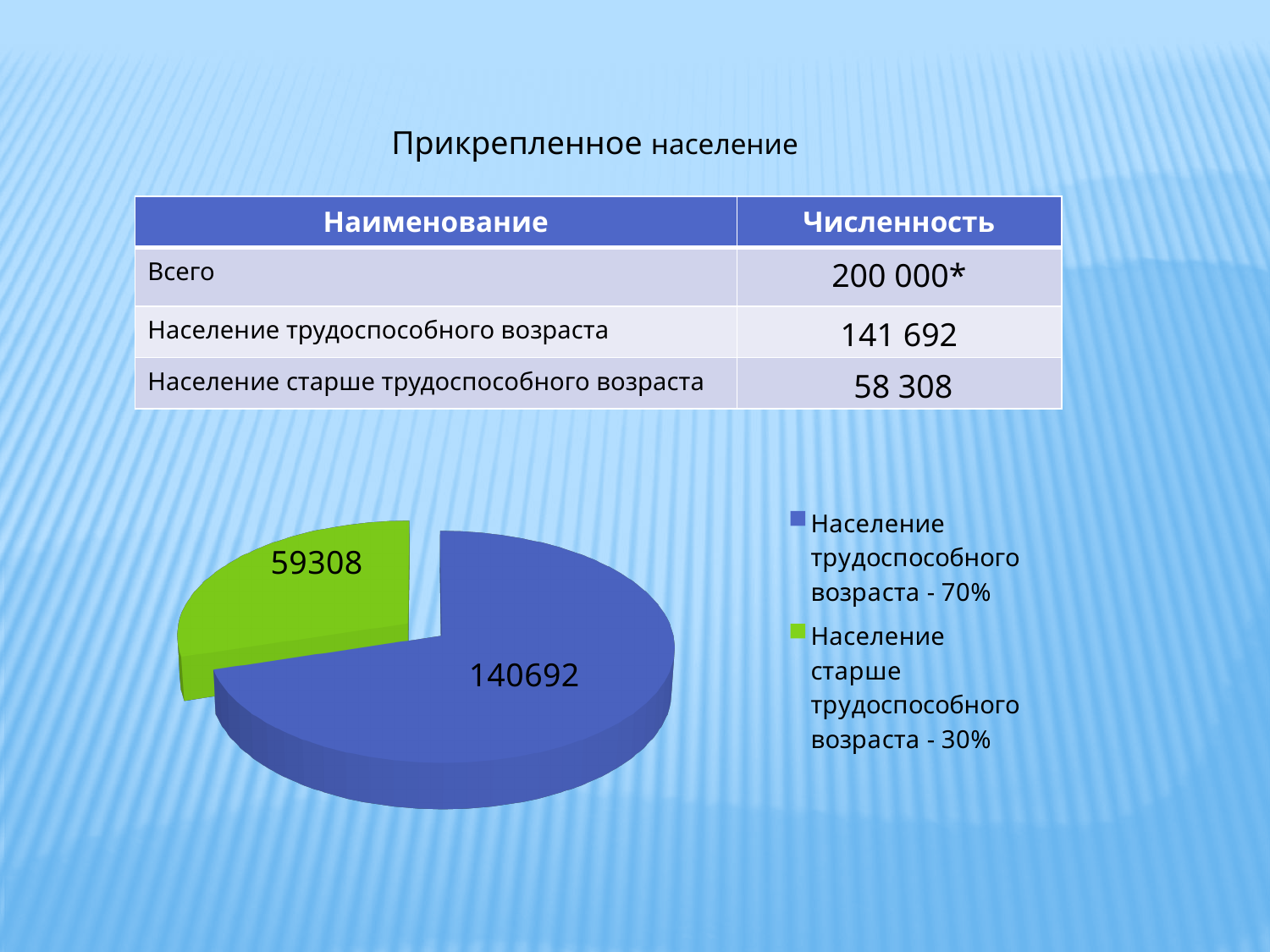
According to the legend, what share of the pie does Население трудоспособного возраста represent? 70% In the pie chart, which is larger: the slice for Население трудоспособного возраста or the slice for Население старше трудоспособного возраста? Население трудоспособного возраста What value is labelled on the blue slice of the pie chart (Население трудоспособного возраста)? 140692 How many slices does the pie chart have? 2 What colour is the slice for Население старше трудоспособного возраста in the pie chart? green Which slice of the pie chart is the smallest? Население старше трудоспособного возраста How many entries does the pie chart's legend list? 2 What is the total of the two slice values shown in the pie chart? 200000 Which slice of the pie chart is the largest? Население трудоспособного возраста What kind of chart is shown on the slide? pie chart What is the difference between the two slice values in the pie chart (140692 and 59308)? 81384 What value is labelled on the green slice of the pie chart (Население старше трудоспособного возраста)? 59308